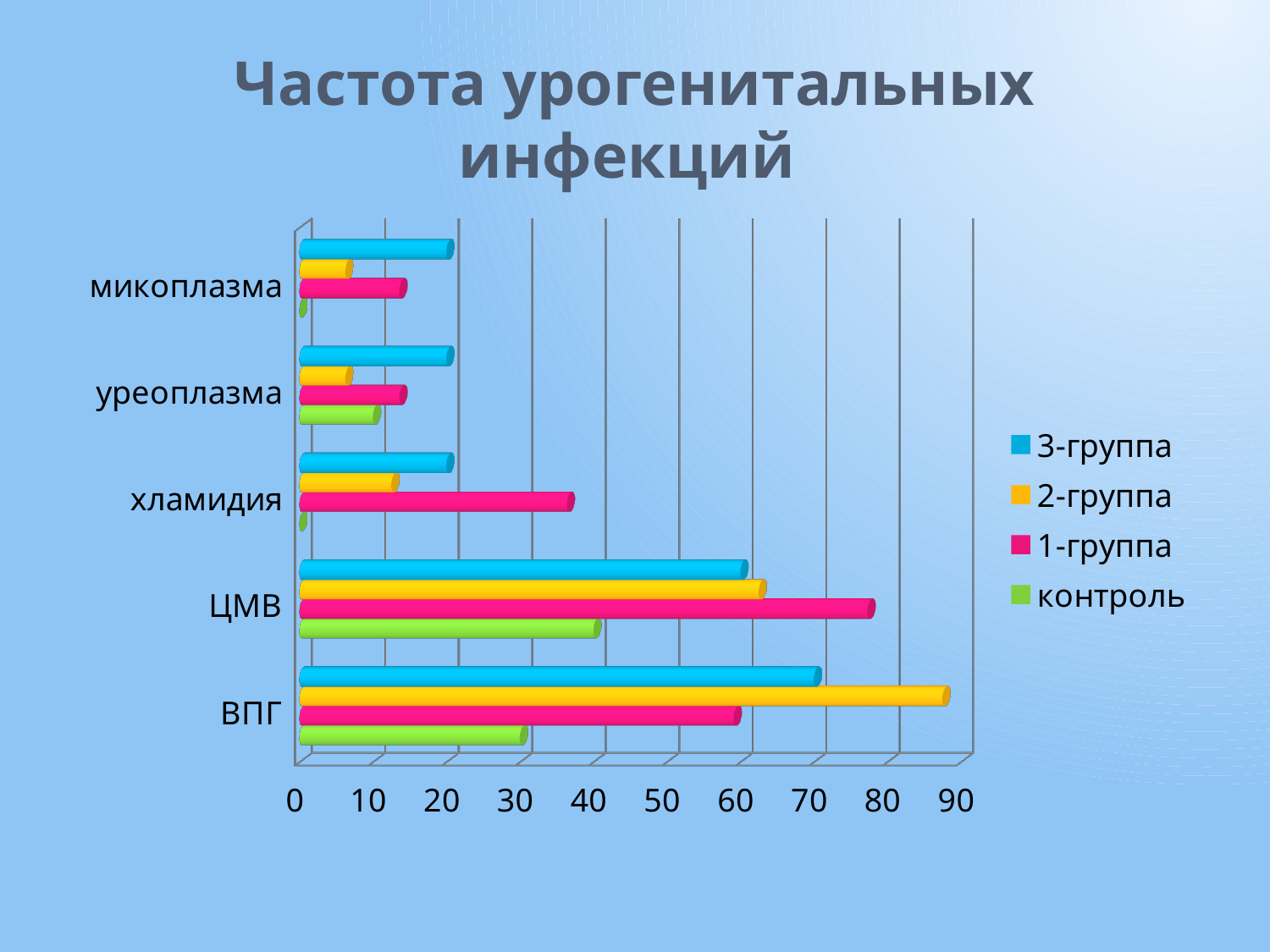
For ВПГ, which series has the larger value: 2-группа or 1-группа? 2-группа What kind of chart is shown on the slide? bar chart How many infection categories are shown on the y axis? 5 Is the value for 1-группа at хламидия greater or less than 30? greater How many series does the legend list? 4 Is the value for контроль at ЦМВ greater or less than 50? less What is the title of the chart? Частота урогенитальных инфекций Is the value for 2-группа at ВПГ greater or less than 80? greater Which category has the highest value for the 1-группа series? ЦМВ Which category has the highest value for the 2-группа series? ВПГ For ЦМВ, which series has the larger value: 1-группа or контроль? 1-группа